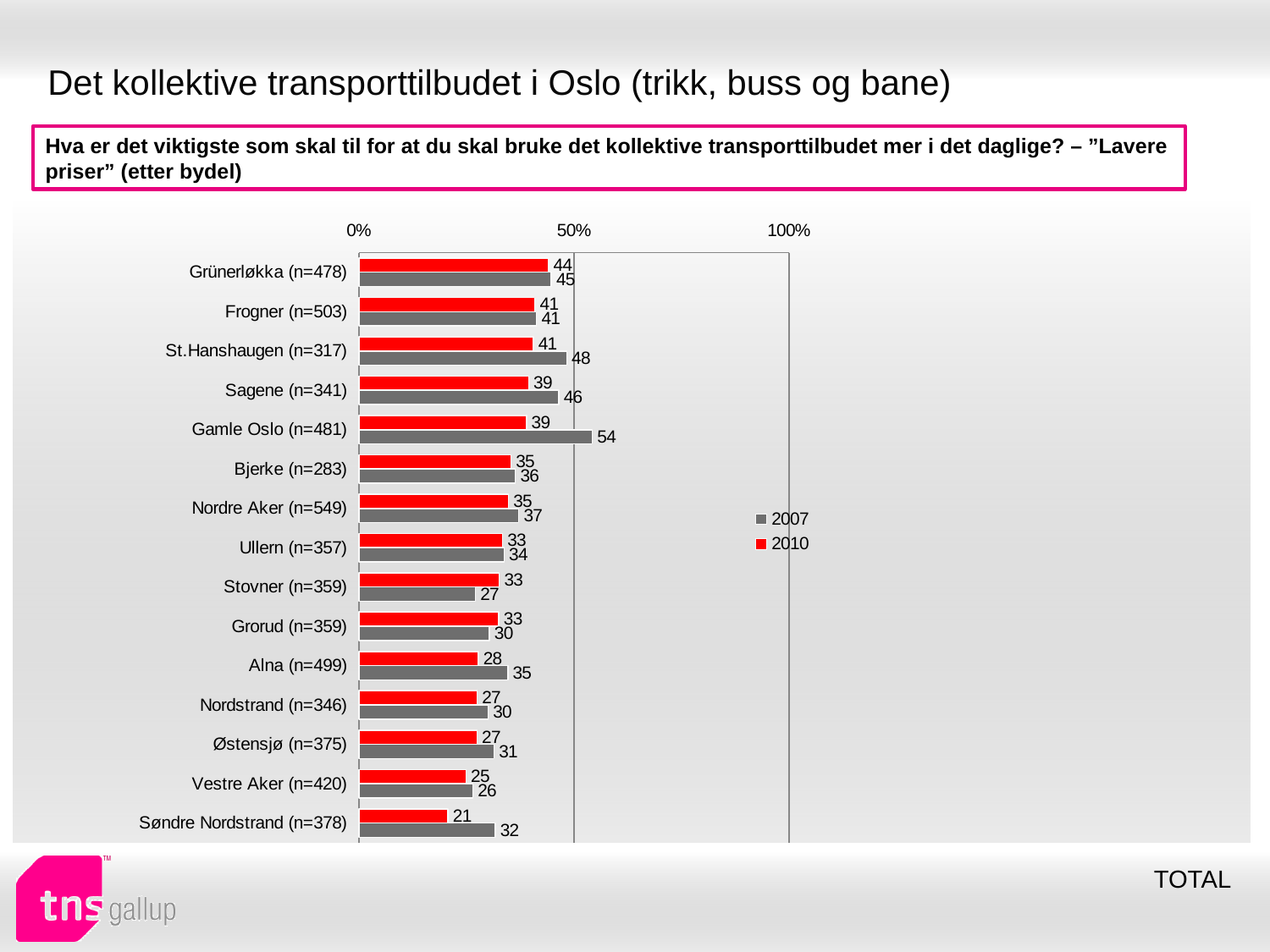
What is the difference between the 2007 and 2010 values for Gamle Oslo (n=481)? 15 Which bydel has the highest 2007 value? Gamle Oslo (n=481) Which colour represents the 2010 series in the chart? Red What is the 2010 value for Søndre Nordstrand (n=378)? 21 What kind of chart is shown on the slide? Bar chart What is the 2007 value for Gamle Oslo (n=481)? 54 How many bydeler (categories) are shown in the chart? 15 Which bydel has the lowest 2010 value? Søndre Nordstrand (n=378) Which is larger for Stovner (n=359), the 2007 value or the 2010 value? 2010 How many series does the legend list? 2 What is the 2010 value for Gamle Oslo (n=481)? 39 What is the 2007 value for St.Hanshaugen (n=317)? 48